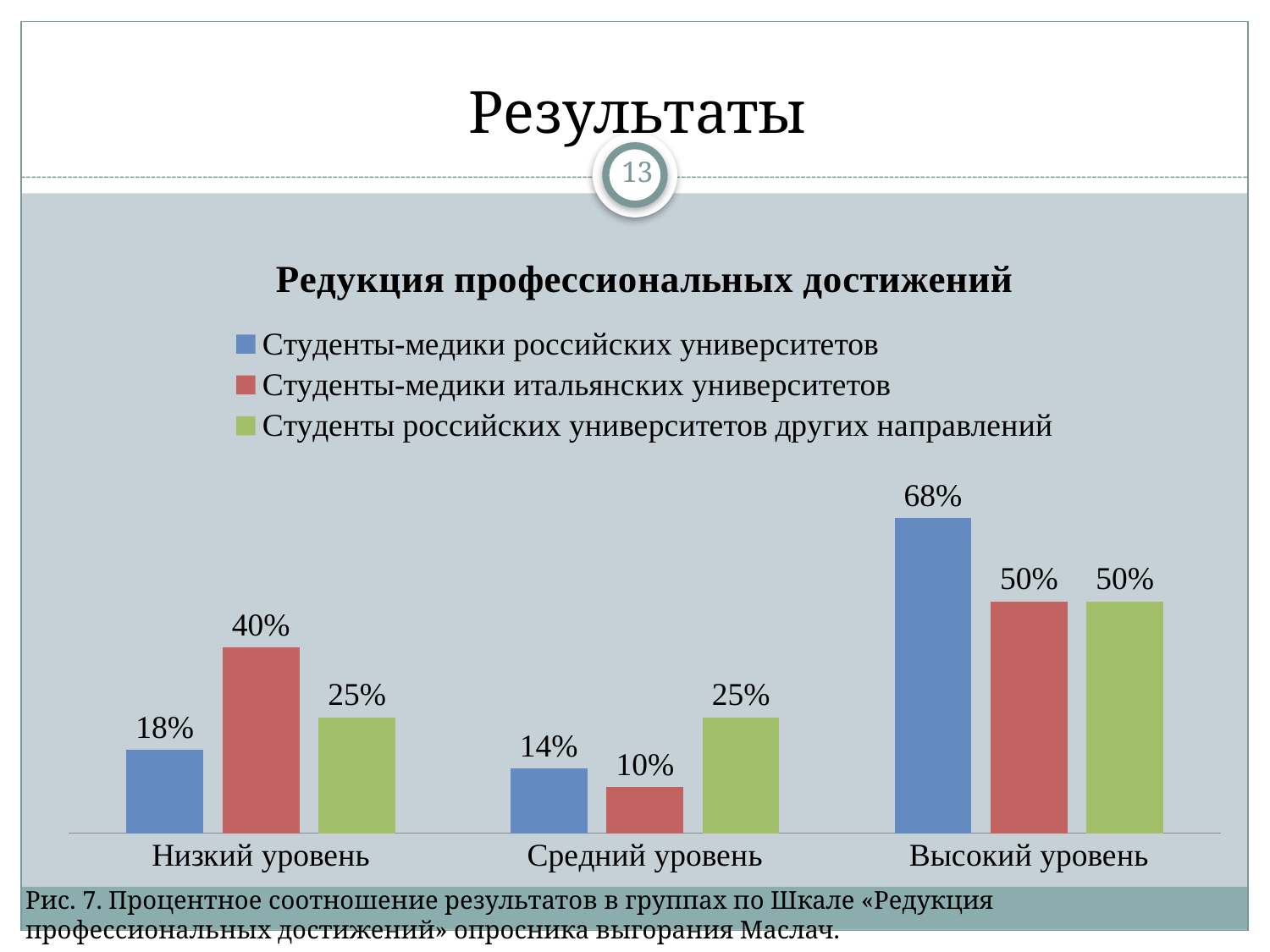
На сколько процентных пунктов значение серии «Студенты-медики итальянских университетов» в категории «Низкий уровень» больше значения серии «Студенты-медики российских университетов» в той же категории? 22% Как называется диаграмма на слайде? Редукция профессиональных достижений Какая серия имеет наибольшее значение в категории «Высокий уровень»? Студенты-медики российских университетов Какого типа эта диаграмма? Столбчатая (bar chart) Сколько серий перечислено в легенде диаграммы? 3 Какое значение у серии «Студенты-медики итальянских университетов» в категории «Низкий уровень»? 40% Каким цветом обозначена серия «Студенты российских университетов других направлений»? Зелёным В какой категории серия «Студенты-медики итальянских университетов» имеет наименьшее значение? Средний уровень Какое значение у серии «Студенты российских университетов других направлений» в категории «Средний уровень»? 25% Какое значение у серии «Студенты-медики российских университетов» в категории «Высокий уровень»? 68% Сколько категорий показано на оси x диаграммы? 3 Какая серия больше в категории «Средний уровень»: «Студенты-медики российских университетов» или «Студенты-медики итальянских университетов»? Студенты-медики российских университетов